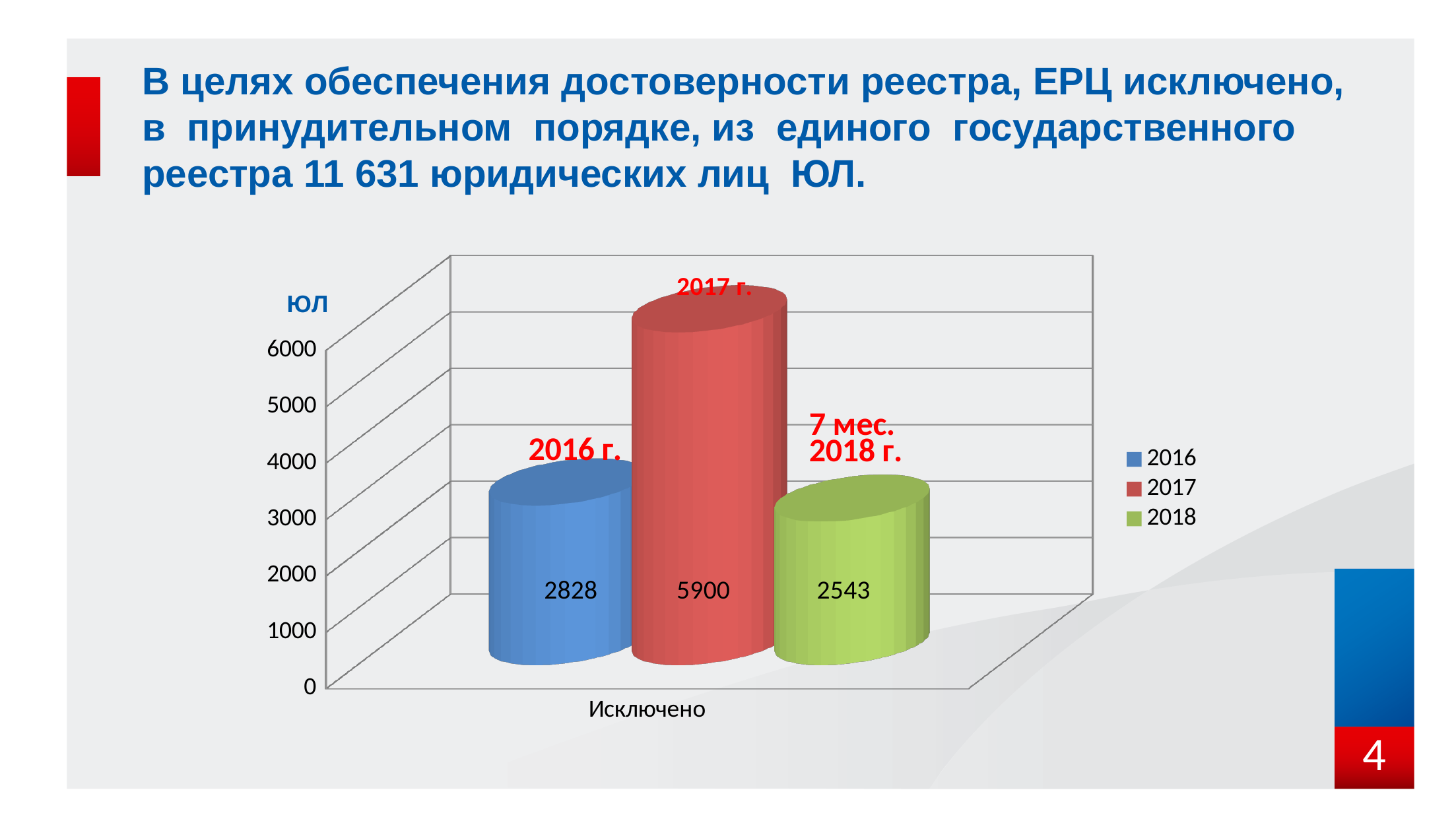
What is the value for 2018 in the chart? 2543 Which series has the highest value? 2017 How many series does the legend list? 3 What is the value for 2017 in the chart? 5900 What is the difference between the 2017 value and the 2016 value? 3072 What kind of chart is shown on the slide? bar chart What is the value for 2016 in the chart? 2828 Which series has the lowest value? 2018 Is the value for 2017 greater or less than 5000? greater What is the category label on the x axis of the chart? Исключено Which is larger, the value for 2016 or the value for 2018? 2016 What is the difference between the 2016 value and the 2018 value? 285